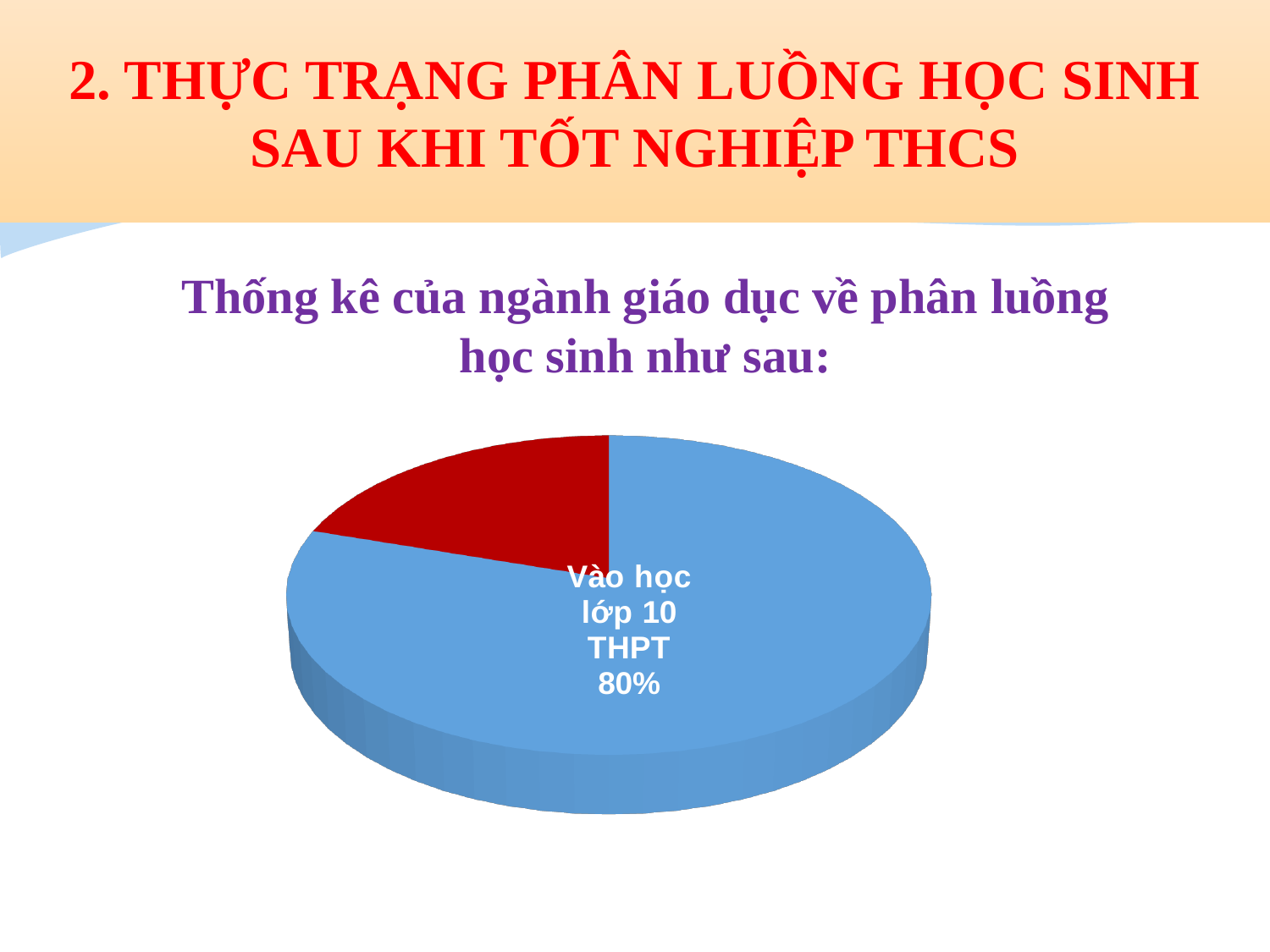
What colour is the slice labelled "Vào học lớp 10 THPT"? Blue Is the share of the slice labelled "Vào học lớp 10 THPT" greater or less than 50%? greater Which slice is larger, the blue slice or the red slice? The blue slice Which slice of the pie chart is the largest? Vào học lớp 10 THPT What share of the pie does the slice labelled "Vào học lớp 10 THPT" represent? 80% How many slices does the pie chart have? 2 What kind of chart is shown on the slide? Pie chart